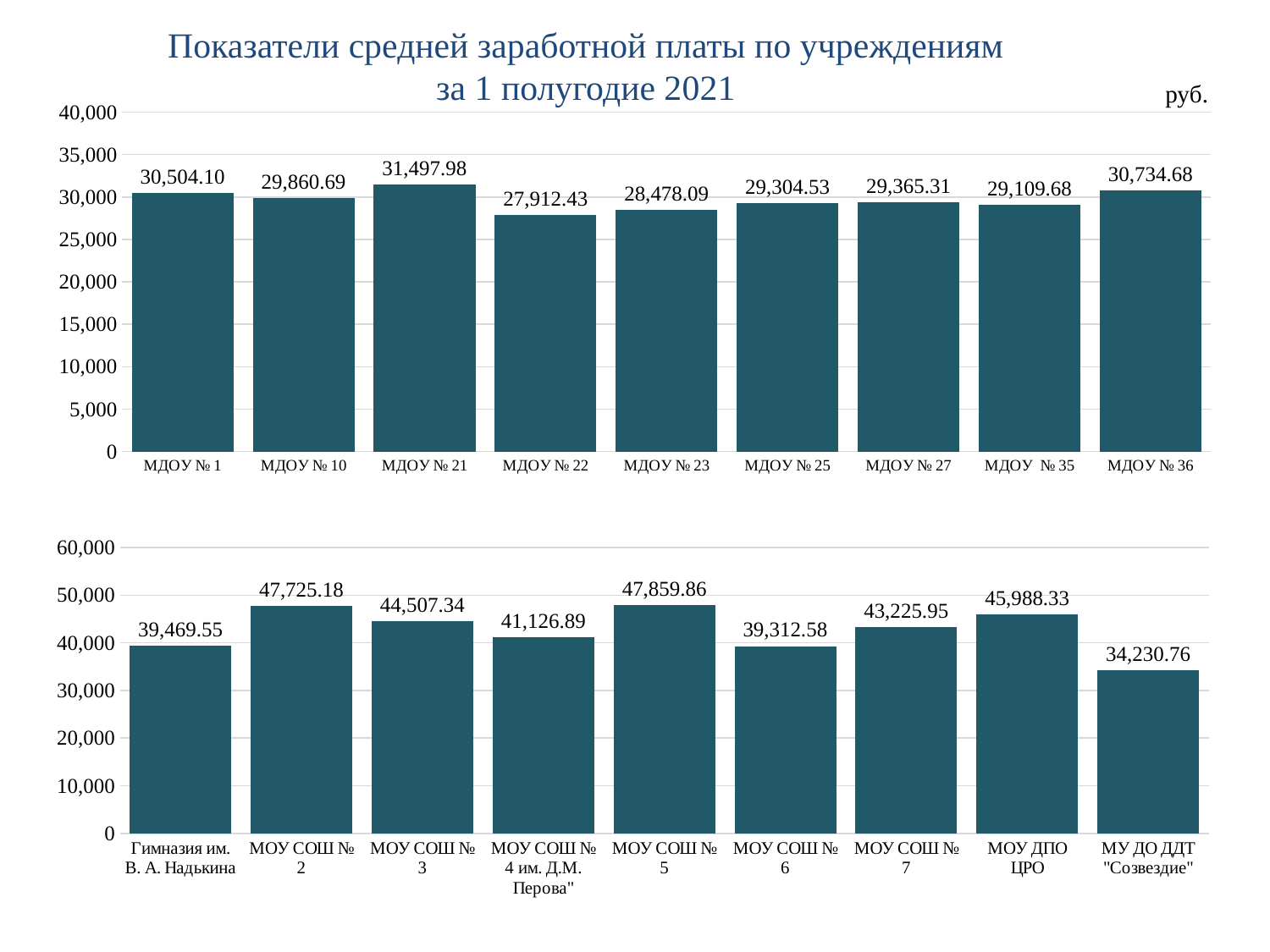
On the top chart, is the value for МДОУ № 36 greater or less than 30,000? greater On the top chart, which institution has the lowest value? МДОУ № 22 On the top chart, what is the difference between the values for МДОУ № 21 and МДОУ № 22? 3,585.55 On the bottom chart, what is the value for МОУ ДПО ЦРО? 45,988.33 On the bottom chart, which institution has the highest value? МОУ СОШ № 5 On the bottom chart, which institution has the lowest value? МУ ДО ДДТ "Созвездие" On the bottom chart, which is larger: the value for МОУ СОШ № 3 or the value for МОУ СОШ № 7? МОУ СОШ № 3 On the top chart, what is the value for МДОУ № 21? 31,497.98 On the top chart, which institution has the highest value? МДОУ № 21 What kind of chart is the top chart? bar chart How many institutions are shown on the bottom chart? 9 On the bottom chart, what is the difference between the values for МОУ СОШ № 5 and МУ ДО ДДТ "Созвездие"? 13,629.10